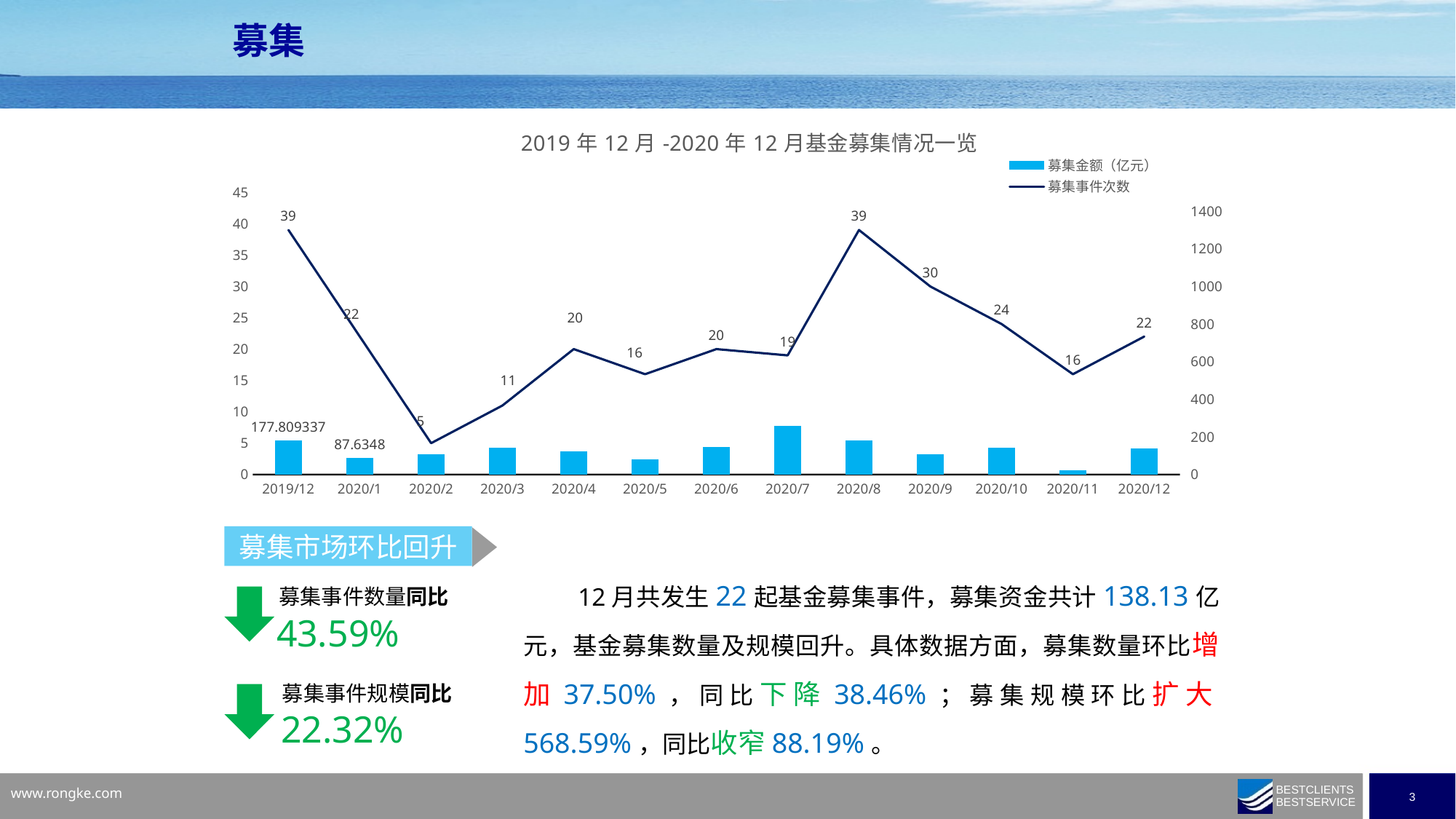
How many months are shown on the x axis? 13 What is the 募集金额（亿元） value labelled for 2019/12? 177.809337 What kind of chart is this? Combination bar and line chart Does the 募集事件次数 line rise or fall from 2020/8 to 2020/11? fall Which month has a higher 募集事件次数, 2020/4 or 2020/5? 2020/4 Which months share the highest 募集事件次数 value? 2019/12 and 2020/8 How many series does the legend list? 2 What is the 募集金额（亿元） value labelled for 2020/1? 87.6348 What is the difference in 募集事件次数 between 2020/9 and 2020/10? 6 Is the 募集金额 bar for 2020/11 greater or less than 100 on the right axis? less Which month has the lowest 募集事件次数? 2020/2 What is the 募集事件次数 value for 2020/8? 39